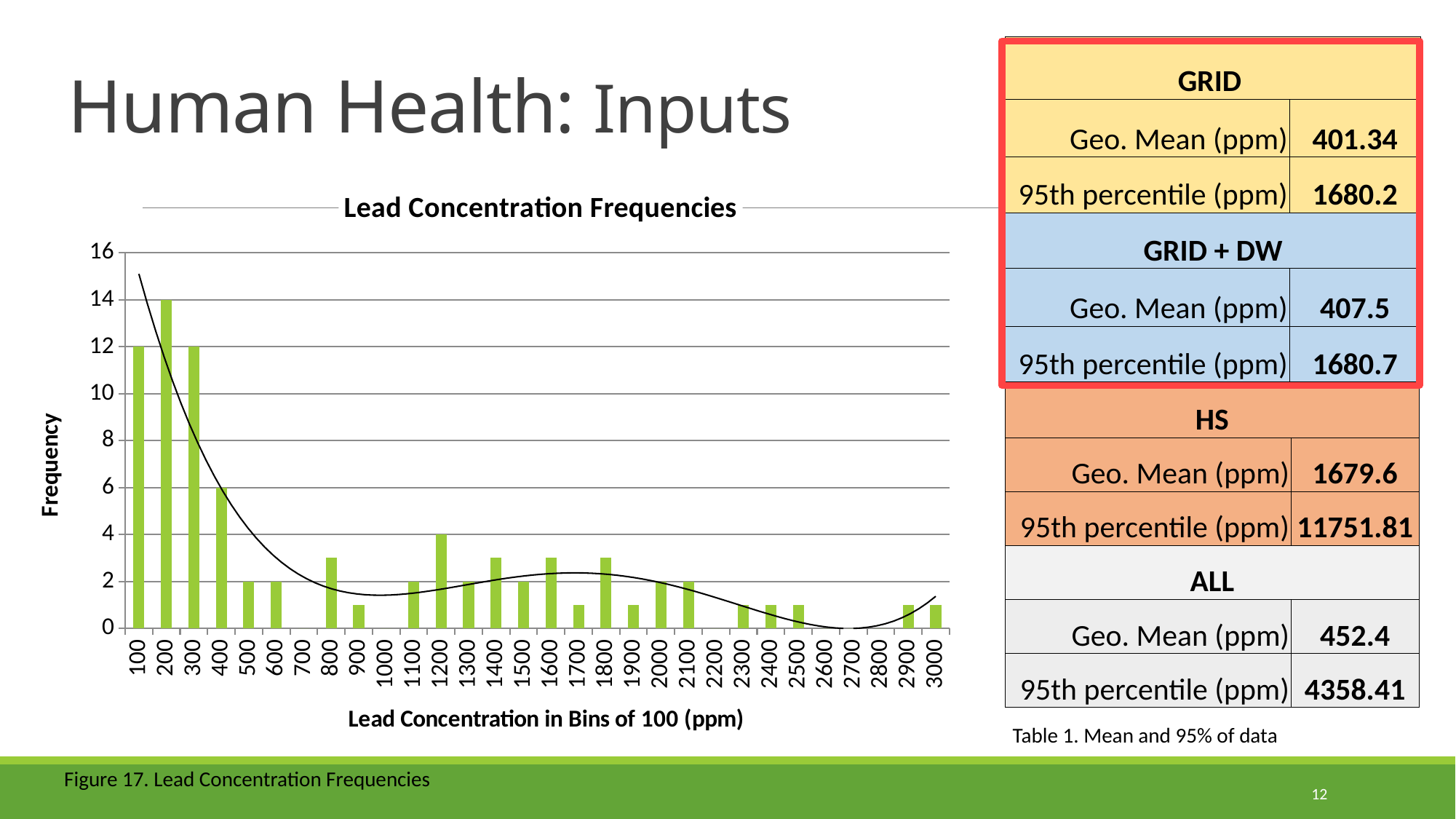
What is the frequency for the 200 ppm bin? 14 What is the frequency for the 400 ppm bin? 6 Is the frequency for the 900 ppm bin greater or less than 2? less How many bins are shown on the x axis? 30 What is the title of the chart? Lead Concentration Frequencies Which bin has a higher frequency, 100 ppm or 400 ppm? 100 Do the frequencies rise or fall from the 200 ppm bin to the 600 ppm bin? fall Which bin has the highest frequency? 200 What is the difference in frequency between the 200 ppm bin and the 400 ppm bin? 8 Is the frequency for the 800 ppm bin greater or less than 2? greater What is the frequency for the 1200 ppm bin? 4 What kind of chart is used to show the lead concentration frequencies? bar chart